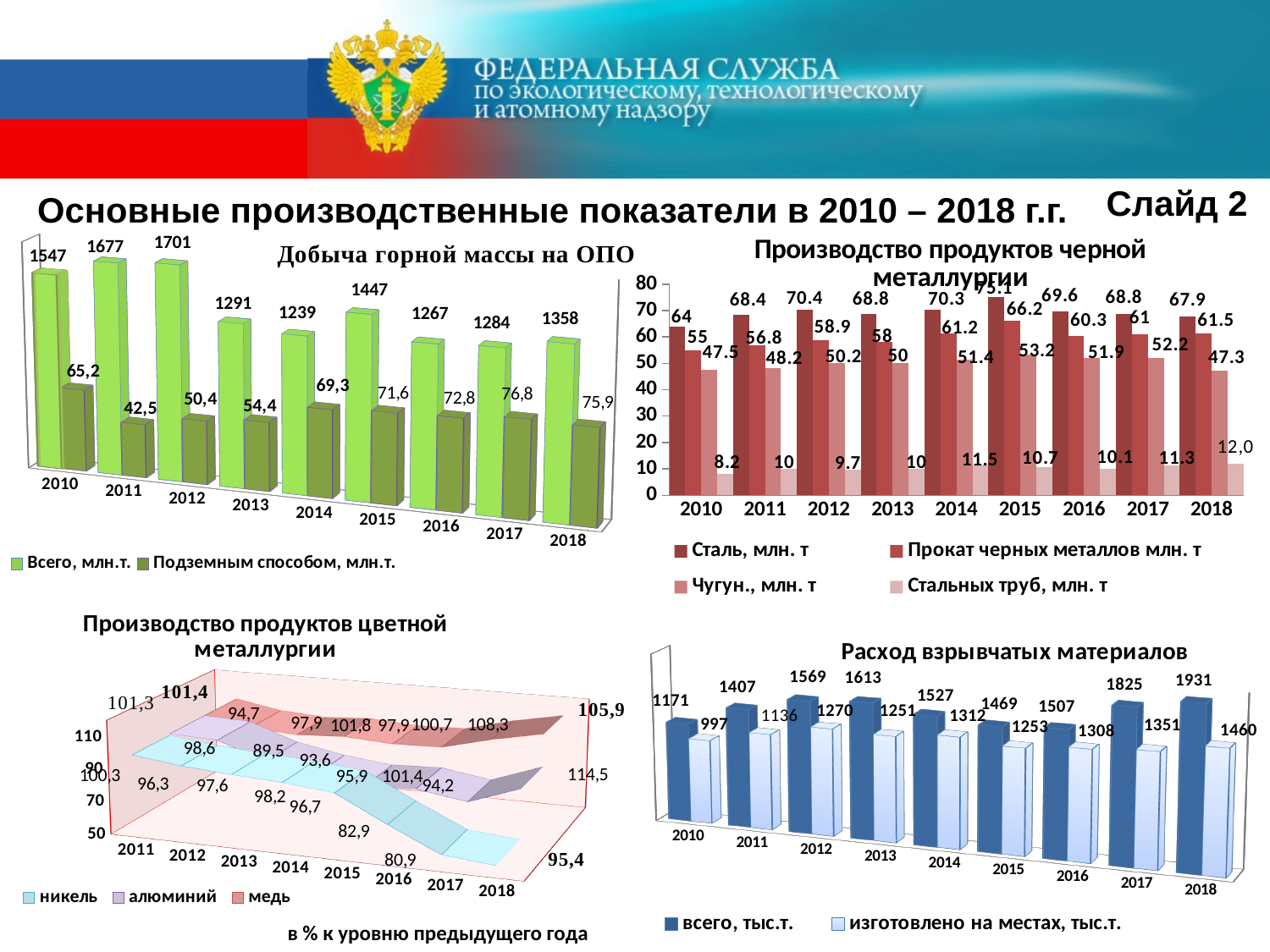
In the chart 'Расход взрывчатых материалов', what is the difference between 'всего, тыс.т.' and 'изготовлено на местах, тыс.т.' in 2017? 474 In the chart 'Добыча горной массы на ОПО', what is the value of 'Всего, млн.т.' for 2012? 1701 In the chart 'Добыча горной массы на ОПО', which year has the lowest value for 'Всего, млн.т.'? 2014 In the chart 'Производство продуктов черной металлургии', what is the value of 'Сталь, млн. т' for 2015? 75.1 In the chart 'Производство продуктов черной металлургии', how many series does the legend list? 4 In the chart 'Расход взрывчатых материалов', how many years are shown on the x axis? 9 In the chart 'Производство продуктов черной металлургии', what is the difference between 'Сталь, млн. т' and 'Прокат черных металлов млн. т' in 2010? 9 In the chart 'Производство продуктов цветной металлургии', how many series does the legend list? 3 In the chart 'Расход взрывчатых материалов', which is larger: 'изготовлено на местах, тыс.т.' in 2014 or in 2015? 2014 In the chart 'Добыча горной массы на ОПО', what is the value of 'Подземным способом, млн.т.' for 2017? 76,8 In the chart 'Производство продуктов черной металлургии', which year has the highest value for 'Стальных труб, млн. т'? 2018 In the chart 'Расход взрывчатых материалов', what is the value of 'всего, тыс.т.' for 2018? 1931